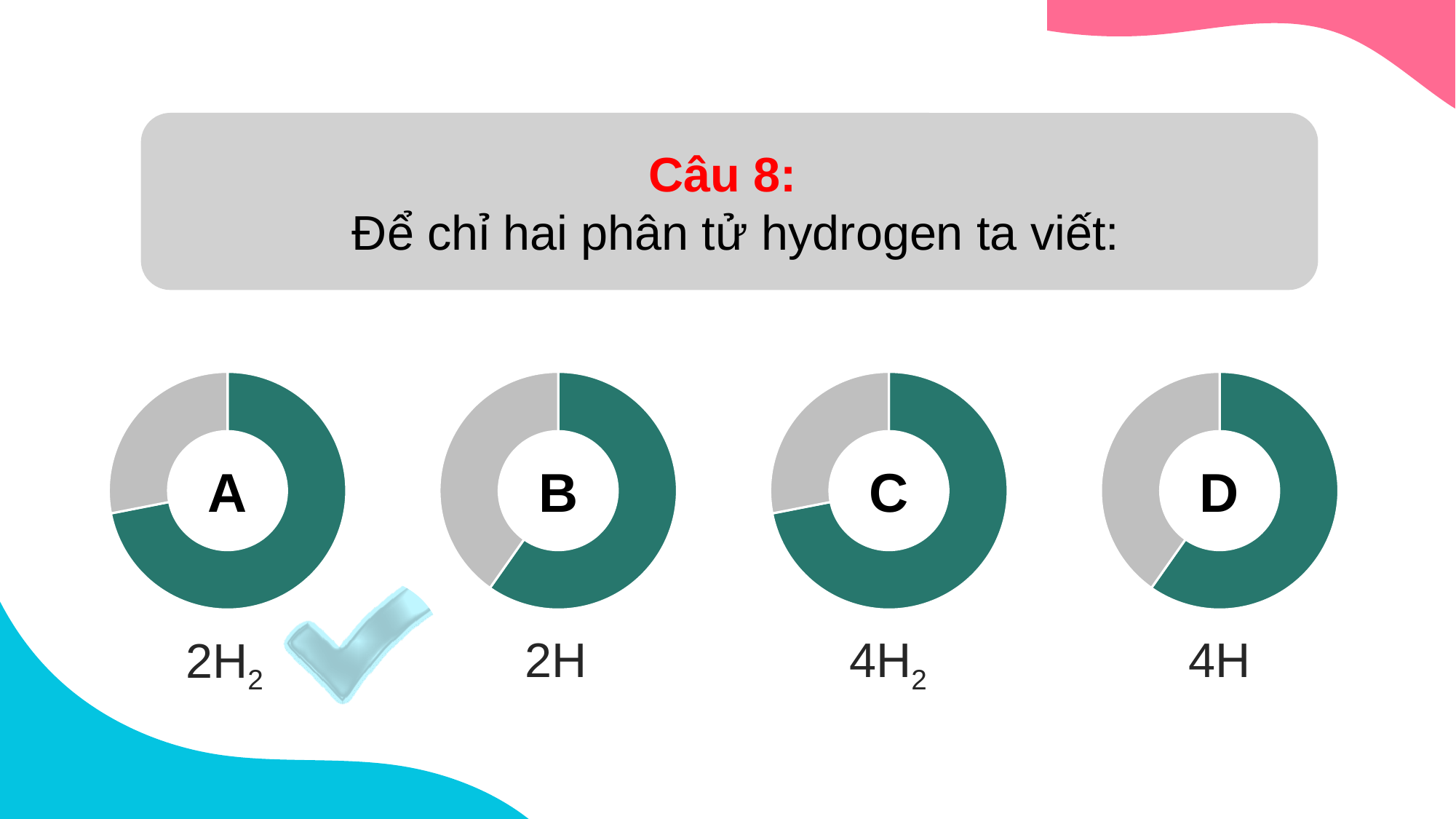
In the chart labelled B, which segment is larger, the green one or the grey one? green In the chart labelled D, which segment is larger, the green one or the grey one? green In the chart labelled C, which segment is larger, the green one or the grey one? green What kind of chart is used for option A on the slide? pie chart (donut) How many segments does the chart labelled A have? 2 What letter is printed in the centre of the leftmost donut chart? A What text appears below the chart labelled C? 4H₂ How many donut charts are shown on the slide? 4